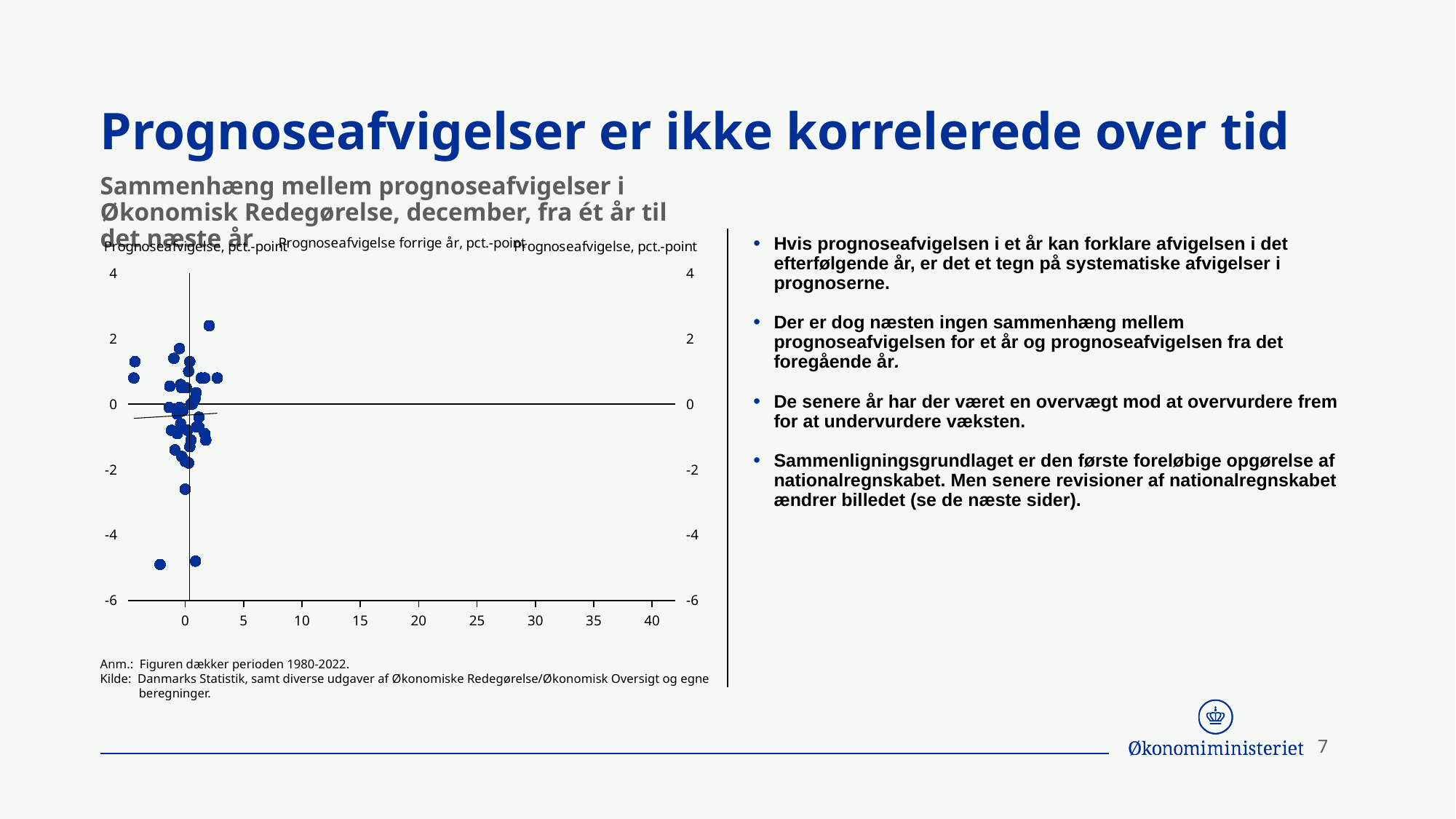
Is the highest point in the chart above or below 2 on the vertical axis? above Is the lowest point in the chart greater or less than -4 on the vertical axis? less What kind of chart is shown on the slide? scatter chart Is the lowest point in the chart greater or less than -6 on the vertical axis? greater What is the title of the chart? Sammenhæng mellem prognoseafvigelser i Økonomisk Redegørelse, december, fra ét år til det næste år What is the label of the horizontal axis of the chart? Prognoseafvigelse forrige år, pct.-point